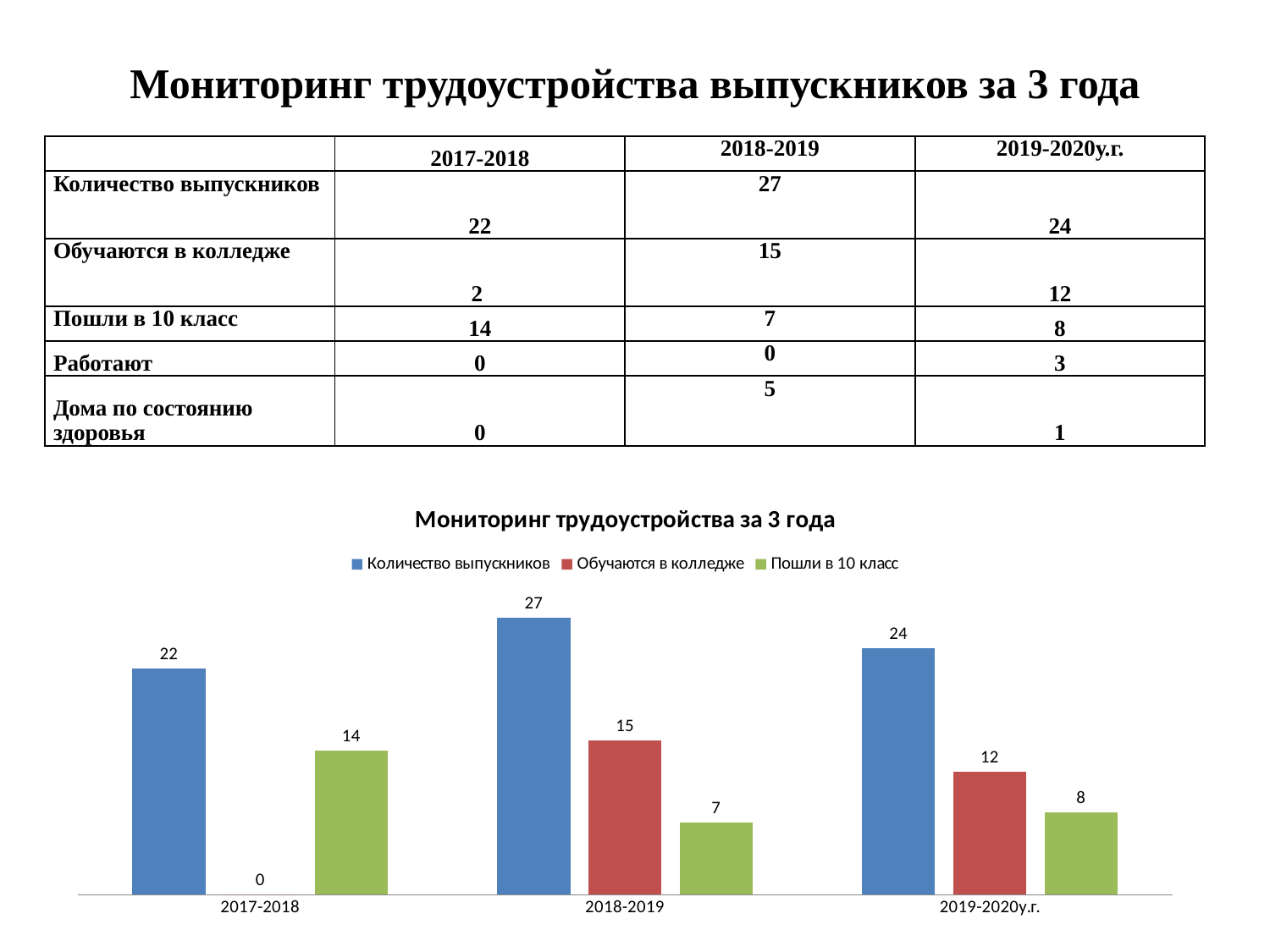
In which year is Количество выпускников highest in the chart? 2018-2019 Which is larger in the chart for 2019-2020у.г.: Обучаются в колледже or Пошли в 10 класс? Обучаются в колледже What value does the chart show for Обучаются в колледже in 2017-2018? 0 How many categories are shown on the x axis of the chart? 3 What is the difference between Количество выпускников and Обучаются в колледже for 2018-2019 in the chart? 12 What is the value of Обучаются в колледже for 2019-2020у.г. in the chart? 12 In which year is Пошли в 10 класс lowest in the chart? 2018-2019 What type of chart is shown on the slide? bar chart What is the value of Пошли в 10 класс for 2017-2018 in the chart? 14 What is the value of Количество выпускников for 2018-2019 in the chart? 27 What is the title of the chart? Мониторинг трудоустройства за 3 года How many series does the chart legend list? 3